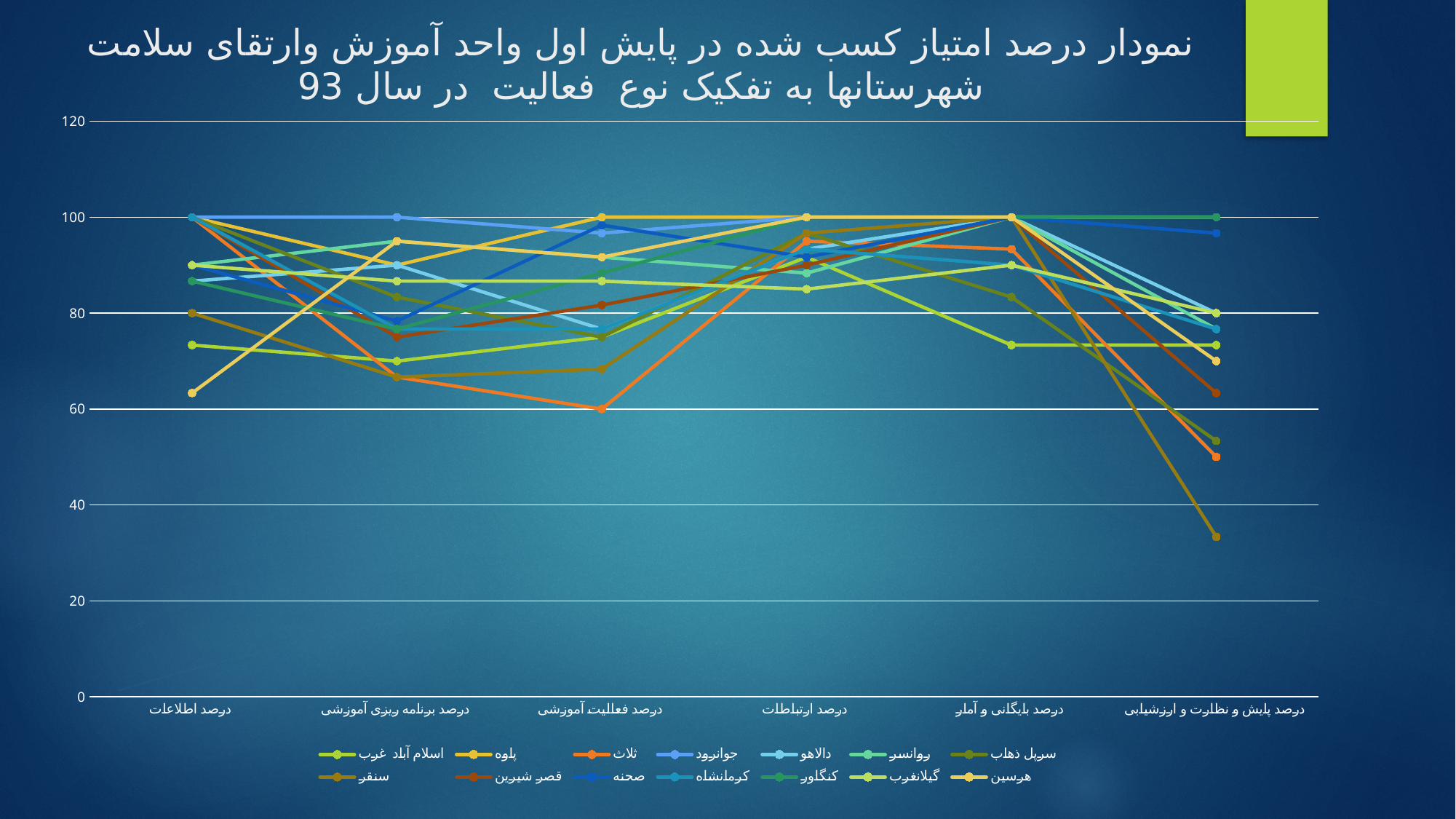
Is the lowest value plotted for درصد اطلاعات greater or less than 60? greater How many categories are shown along the x axis? 6 What is the label of the last category on the x axis? درصد پایش و نظارت و ارزشیابی Is the lowest value plotted for درصد بایگانی و آمار greater or less than 60? greater What is the highest value shown on the y axis? 120 Is the lowest value plotted for درصد پایش و نظارت و ارزشیابی greater or less than 40? less What kind of chart is shown on the slide? line chart How many series does the legend list? 14